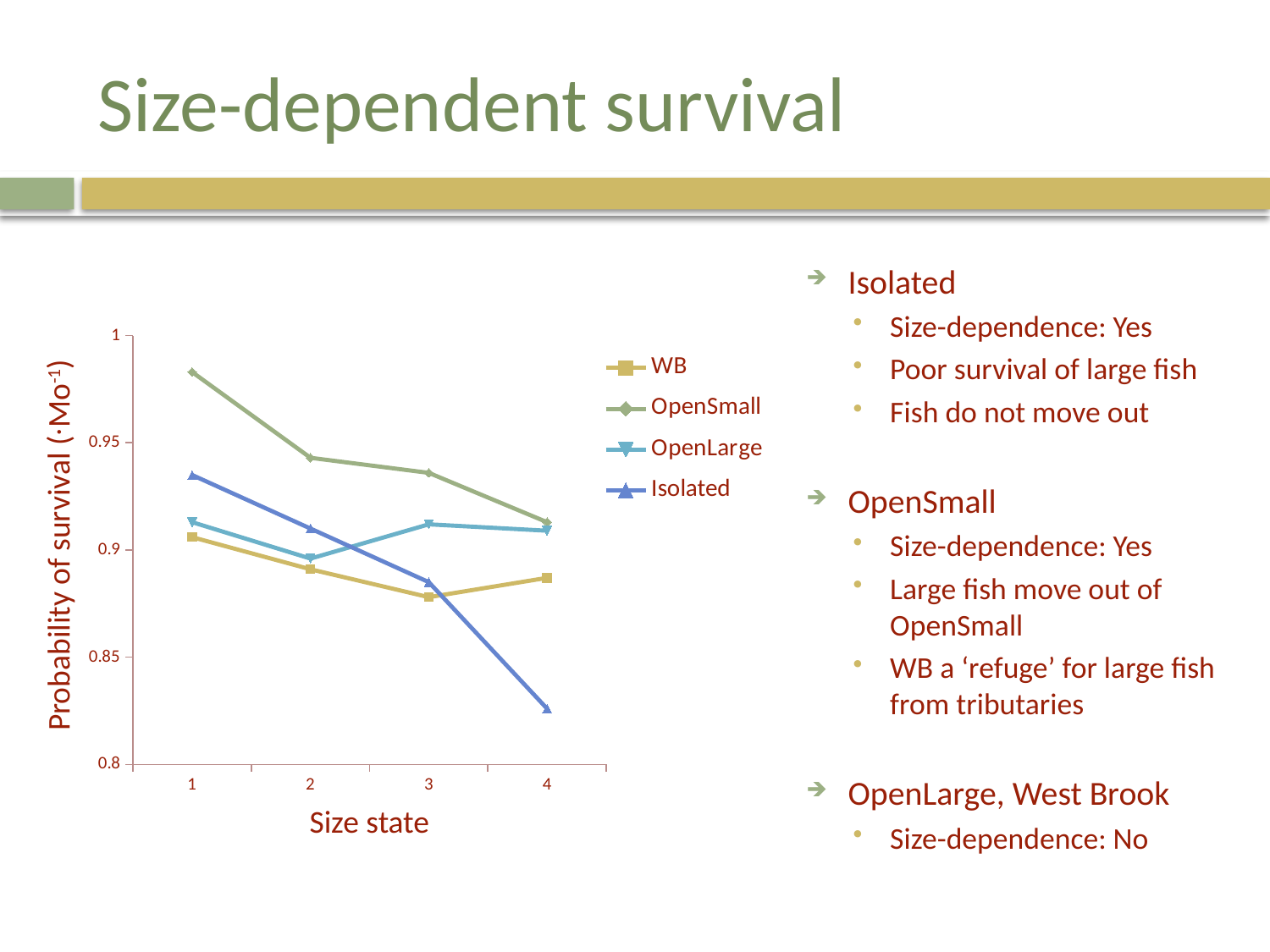
Is the value for OpenSmall at size state 1 greater or less than 0.95? greater Does the OpenSmall series rise or fall as size state increases from 1 to 4? Fall How many series does the chart's legend list? 4 What is the label of the x axis? Size state Which series has the lowest probability of survival at size state 4? Isolated Does the Isolated series rise or fall as size state increases from 1 to 4? Fall How many size states are plotted along the x axis? 4 What kind of chart is shown on the slide? Line chart Which series has the highest probability of survival at size state 1? OpenSmall At size state 1, which is larger: the value for OpenSmall or the value for Isolated? OpenSmall Is the value for WB at size state 3 greater or less than 0.9? less Is the value for Isolated at size state 4 greater or less than 0.85? less